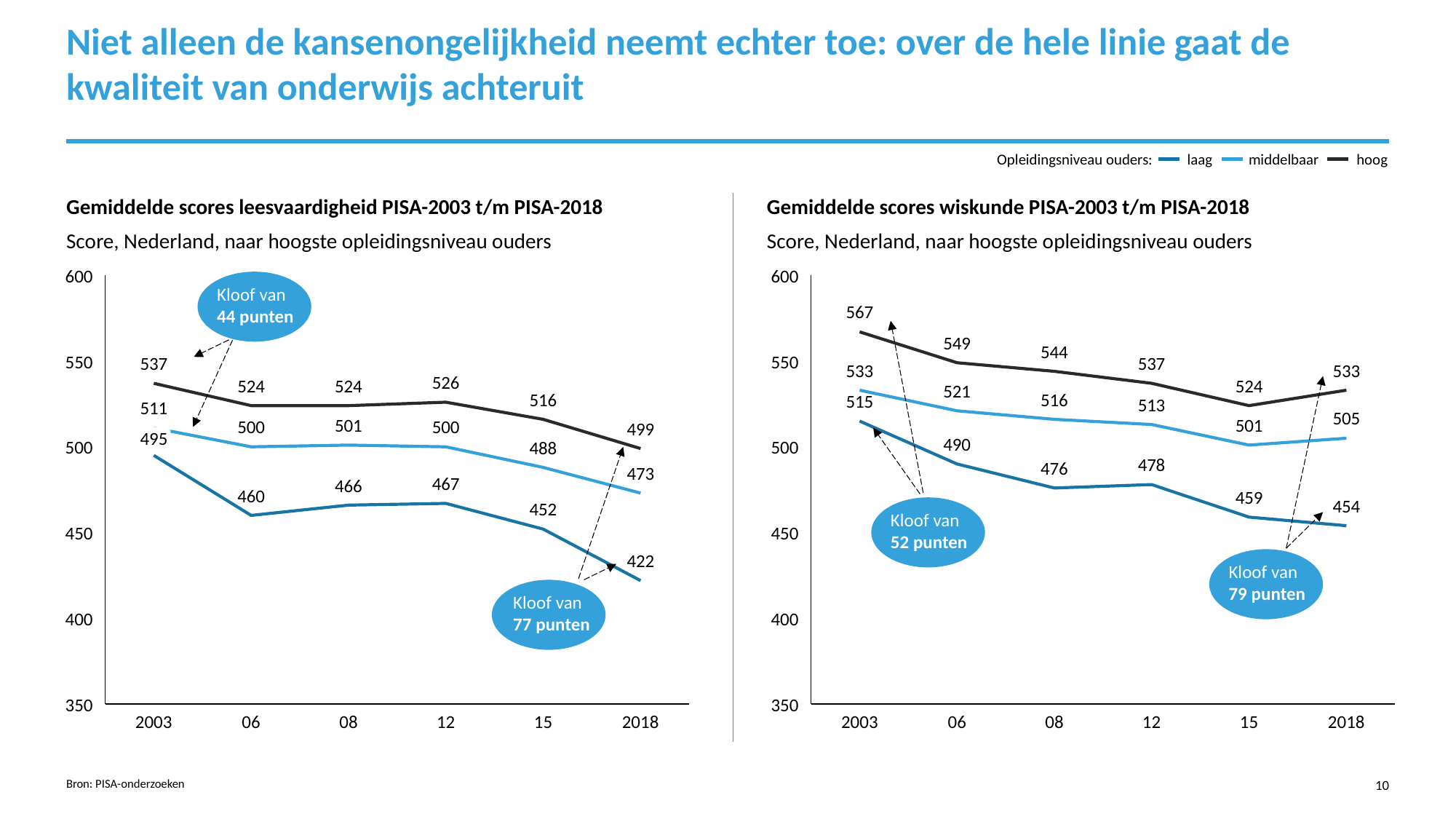
How many series does the legend list? 3 In the right chart (Gemiddelde scores wiskunde), what is the difference between the 'hoog' and 'laag' scores in 2003? 52 In the left chart (Gemiddelde scores leesvaardigheid), what is the score for 'hoog' in 2003? 537 In the right chart (Gemiddelde scores wiskunde), what is the score for 'middelbaar' in 2015? 501 In the left chart (Gemiddelde scores leesvaardigheid), what is the difference between the 'hoog' and 'laag' scores in 2018? 77 In the left chart (Gemiddelde scores leesvaardigheid), in which year is the 'laag' score lowest? 2018 In the right chart (Gemiddelde scores wiskunde), what is the score for 'laag' in 2008? 476 What kind of chart is the right chart (Gemiddelde scores wiskunde)? Line chart In the left chart (Gemiddelde scores leesvaardigheid), does the 'hoog' score rise or fall from 2003 to 2018? Fall In the left chart (Gemiddelde scores leesvaardigheid), what is the score for 'laag' in 2018? 422 In the left chart (Gemiddelde scores leesvaardigheid), which is larger: the 'middelbaar' score in 2003 or in 2018? 2003 In the right chart (Gemiddelde scores wiskunde), in which year is the 'hoog' score highest? 2003